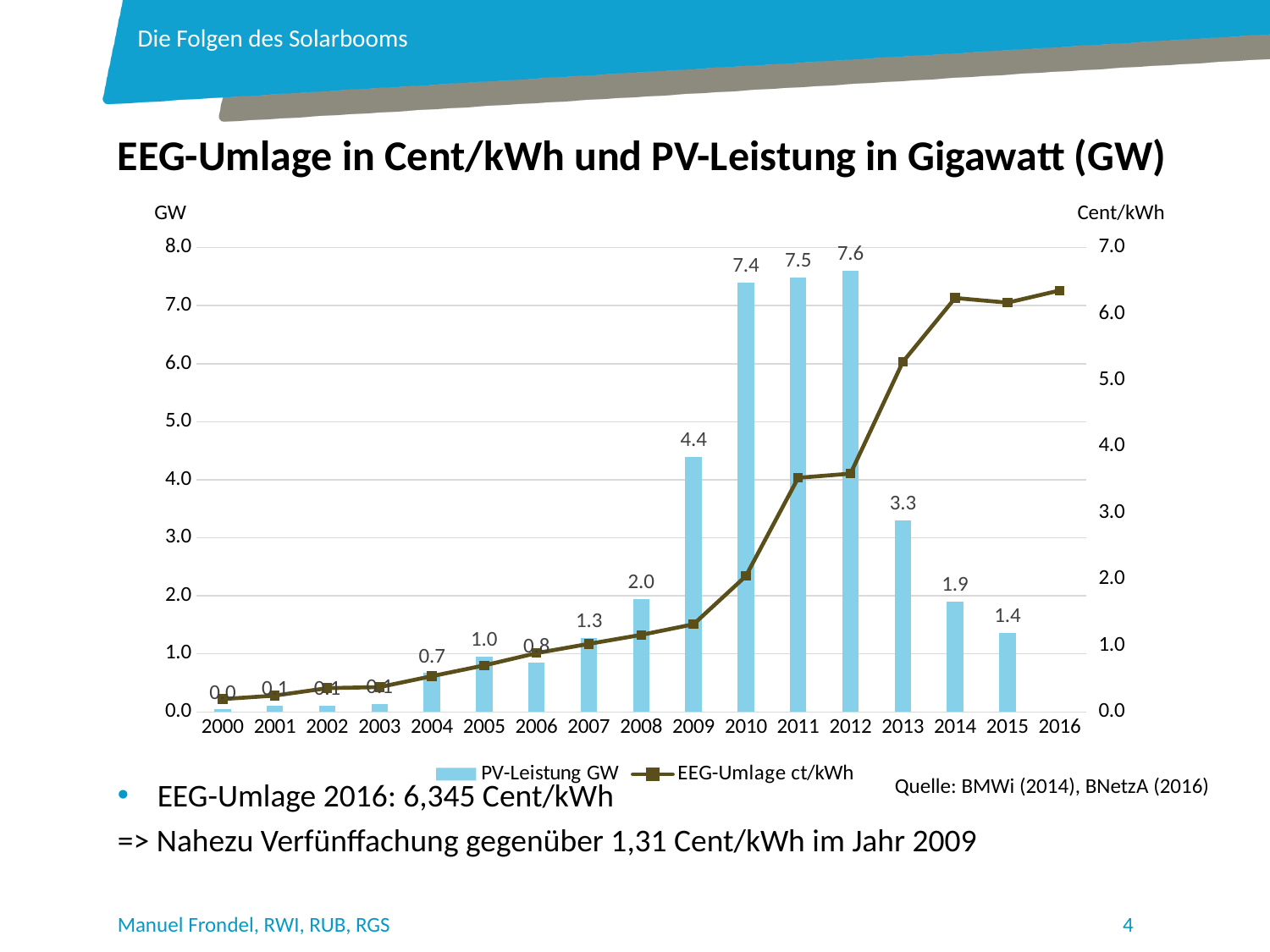
How many years are shown on the x axis? 17 What is the PV-Leistung GW value for 2012? 7.6 How many series does the legend list? 2 What is the PV-Leistung GW value for 2015? 1.4 Which year has the highest PV-Leistung GW bar? 2012 What kind of chart is this? Combined bar and line chart What is the PV-Leistung GW value for 2009? 4.4 What is the difference between the PV-Leistung GW values for 2012 and 2013? 4.3 Is the EEG-Umlage ct/kWh value for 2016 greater or less than 6.0? greater Does the EEG-Umlage ct/kWh line generally rise or fall from 2000 to 2016? Rise Is the EEG-Umlage ct/kWh value for 2009 greater or less than 2.0? less Which is larger, the PV-Leistung GW value for 2008 or for 2014? 2008